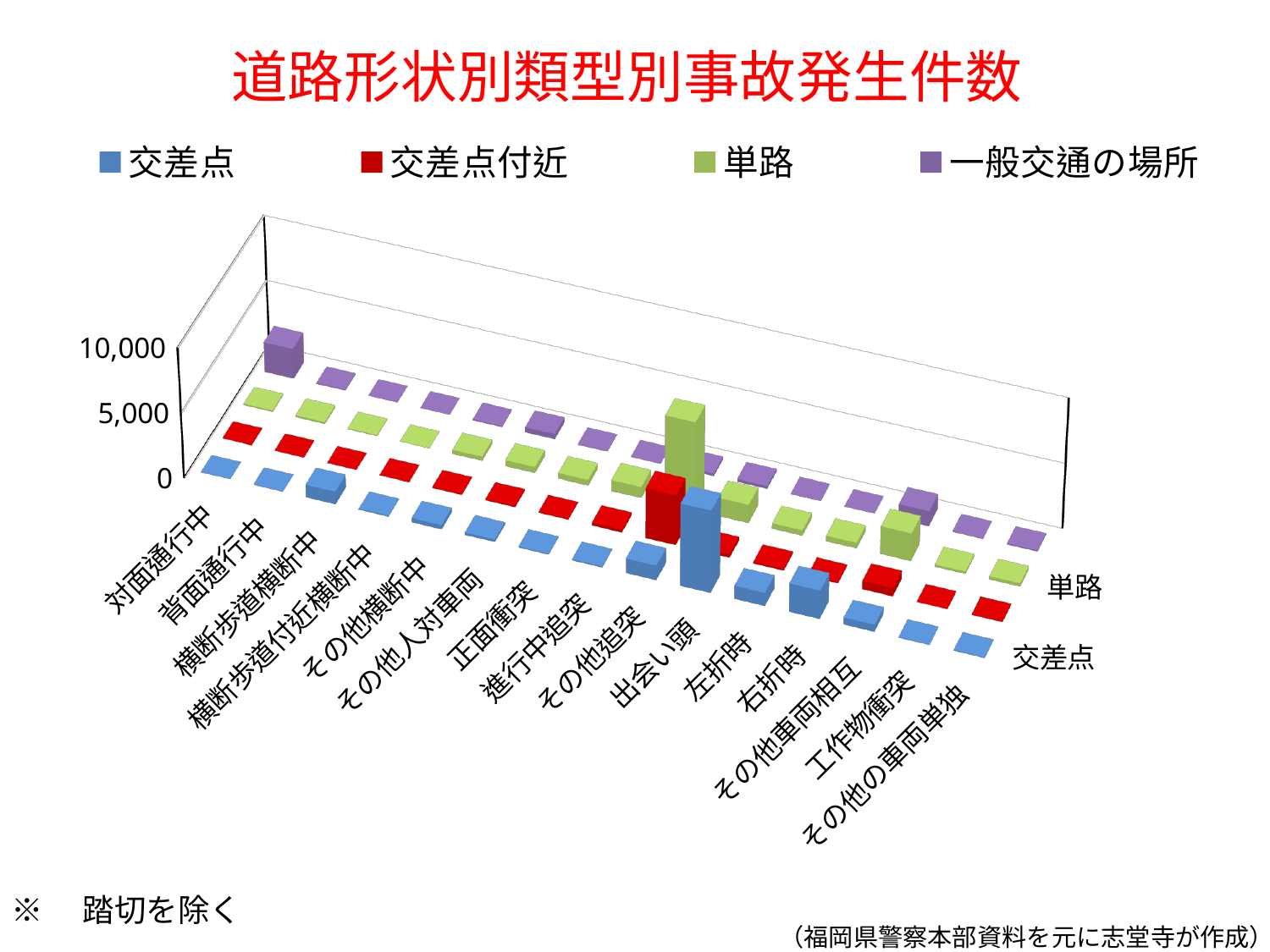
For the 交差点付近 series, which category has the highest value? その他追突 In the 単路 series, which is larger: その他追突 or 工作物衝突? その他追突 Which series is shown in red in the legend? 交差点付近 How many accident-type categories are plotted along the x axis? 15 For the 交差点 series, which category has the highest value? 出会い頭 What kind of chart is shown on the slide? bar chart What is the title of the chart? 道路形状別類型別事故発生件数 How many series does the legend list? 4 In the 交差点 series, which is larger: 出会い頭 or 左折時? 出会い頭 Is the value for 対面通行中 in the 交差点 series greater or less than 5,000? less For the 一般交通の場所 series, which category has the highest value? 対面通行中